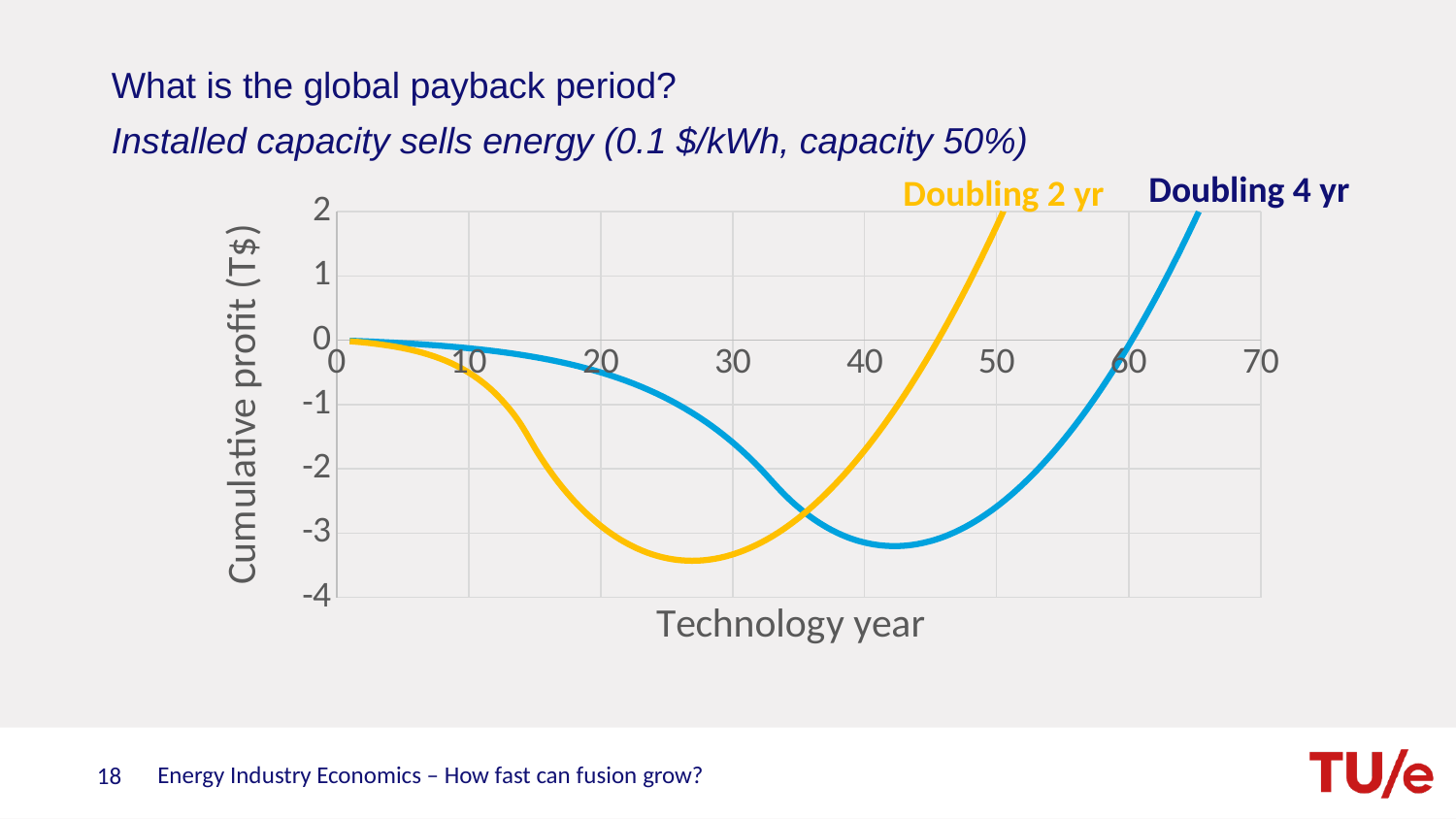
Is the cumulative profit for Doubling 4 yr at technology year 40 greater or less than -3? less At technology year 30, which series has the lower cumulative profit, Doubling 2 yr or Doubling 4 yr? Doubling 2 yr What is the title of the y axis? Cumulative profit (T$) Does the cumulative profit for Doubling 2 yr rise or fall between technology year 30 and technology year 50? rise Is the cumulative profit for Doubling 2 yr at technology year 30 greater or less than -3? less How many series are plotted on the chart? 2 What is the title of the x axis? Technology year Which series returns to a cumulative profit of 0 at an earlier technology year? Doubling 2 yr Is the cumulative profit for Doubling 2 yr at technology year 50 greater or less than 1? greater What kind of chart is shown on the slide? line chart What is the cumulative profit of both series at technology year 0? 0